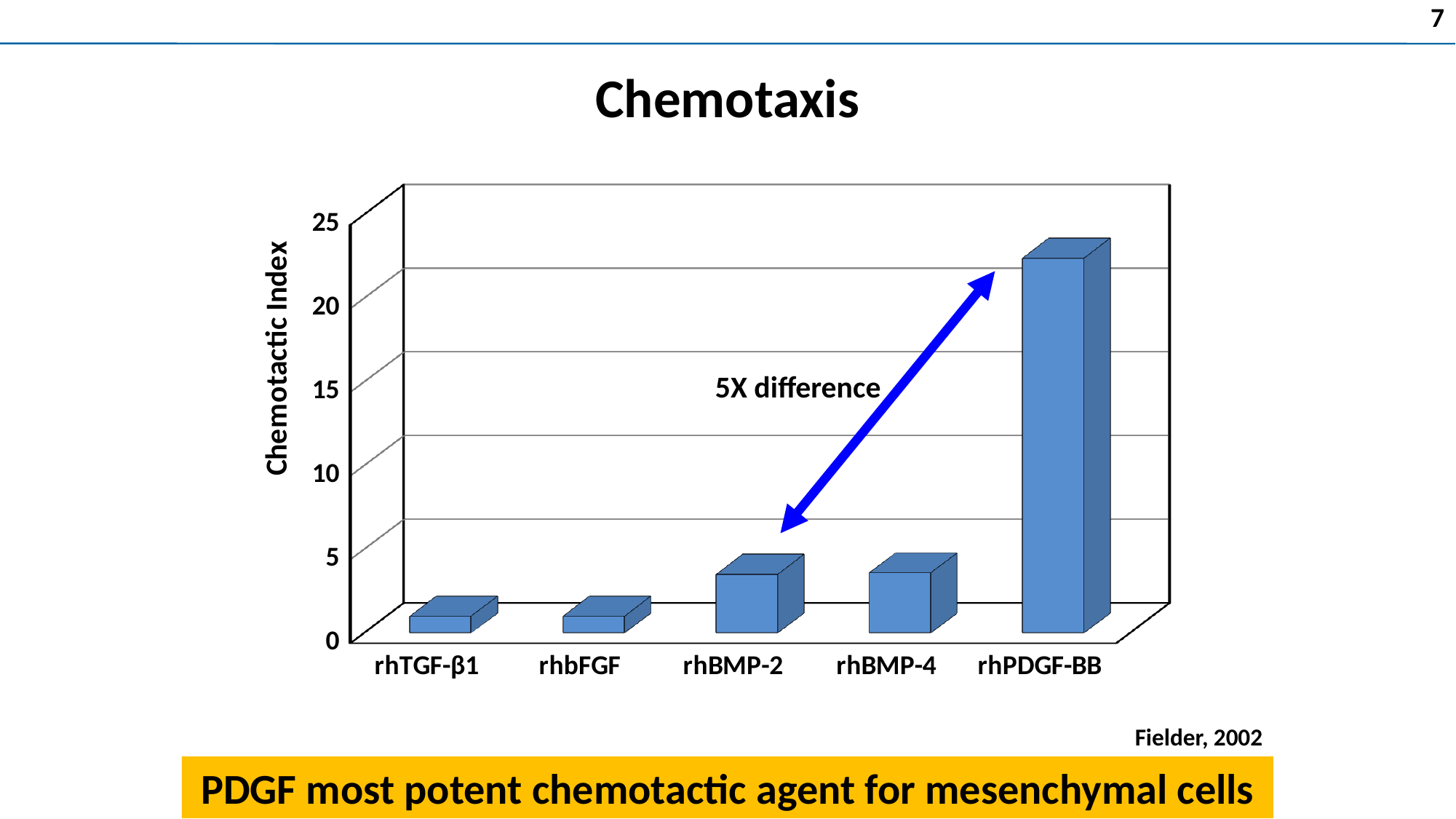
How many categories are plotted on the x axis of the chart? 5 Is the Chemotactic Index for rhTGF-β1 greater or less than 5? less What is the title of the chart? Chemotaxis Is the Chemotactic Index for rhbFGF greater or less than 5? less Which category has the highest Chemotactic Index? rhPDGF-BB Which has a larger Chemotactic Index, rhBMP-4 or rhPDGF-BB? rhPDGF-BB What kind of chart is shown on the slide? bar chart Which has a larger Chemotactic Index, rhbFGF or rhBMP-2? rhBMP-2 Is the Chemotactic Index for rhBMP-2 greater or less than 10? less What is the label on the y axis of the chart? Chemotactic Index